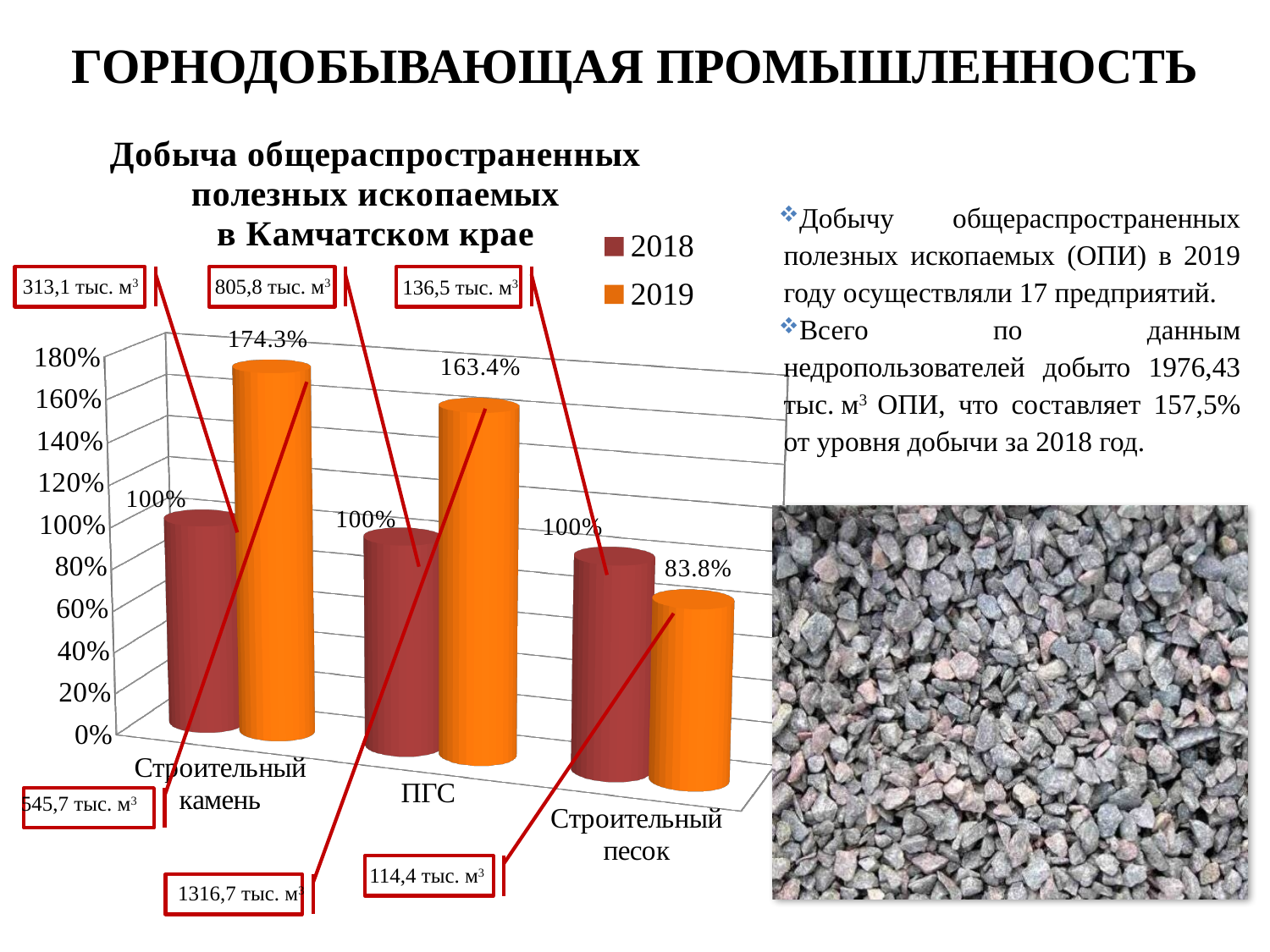
Which category has the lowest 2019 value? Строительный песок What kind of chart is shown on the slide? bar chart Which category has the highest 2019 value? Строительный камень What is the 2018 value for ПГС? 100% What is the 2019 value for Строительный камень? 174.3% What is the 2019 value for ПГС? 163.4% What is the difference between the 2019 values for Строительный камень and ПГС? 10.9% How many series does the legend list? 2 What is the 2019 value for Строительный песок? 83.8% Which is larger for Строительный песок: the 2018 value or the 2019 value? 2018 Is the 2019 value for ПГС greater or less than 140%? greater How many categories are shown on the x axis? 3